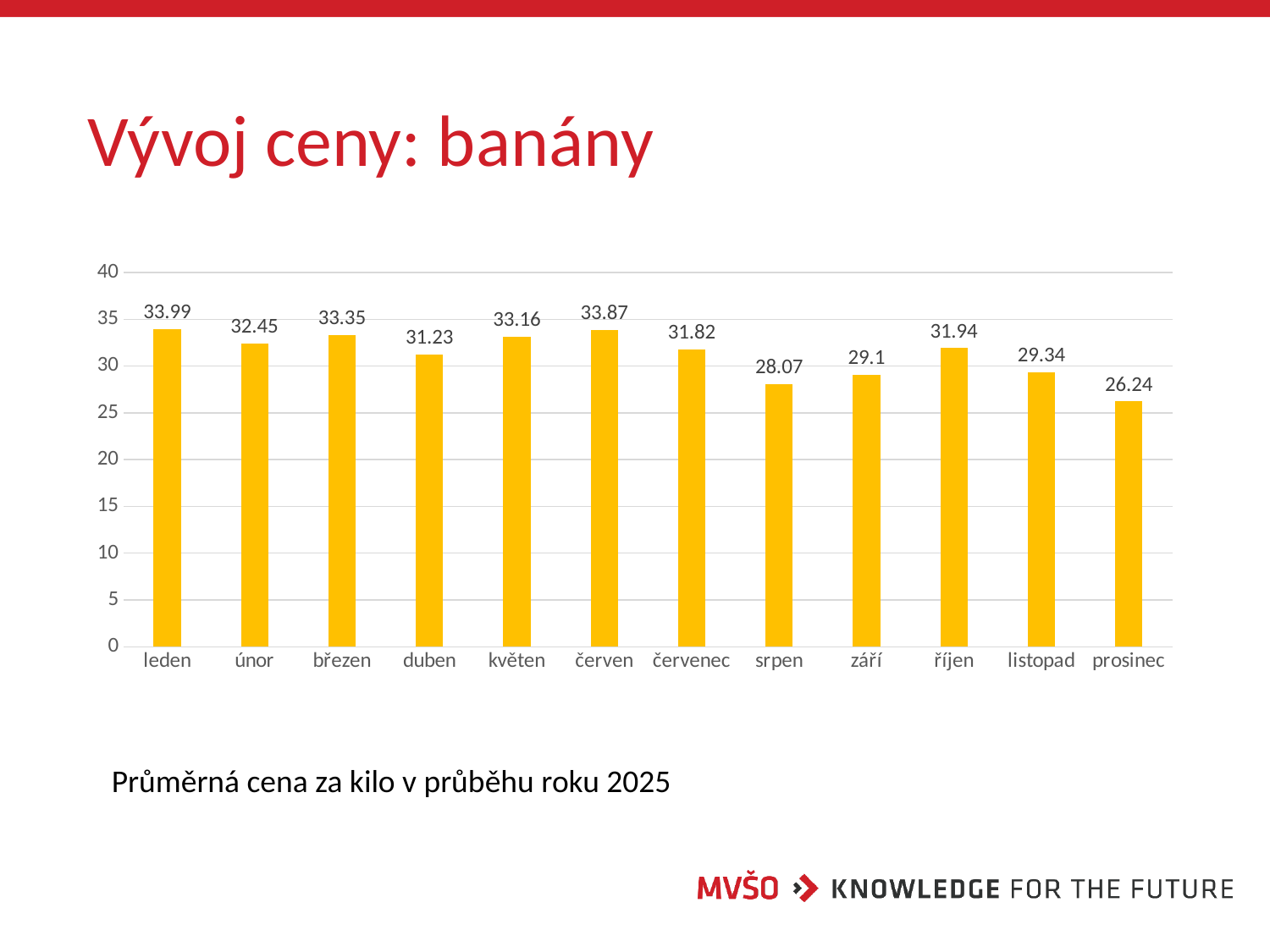
Which is larger, the value for březen or the value for duben? březen What is the difference between the values for leden and prosinec? 7.75 What is the title of the slide containing the chart? Vývoj ceny: banány Is the value for srpen greater or less than 30? less What is the value for srpen? 28.07 What kind of chart is shown on the slide? bar chart What is the difference between the values for říjen and září? 2.84 What is the value for leden? 33.99 What is the value for prosinec? 26.24 Which month has the lowest value? prosinec Which month has the highest value? leden How many months are shown on the x axis? 12